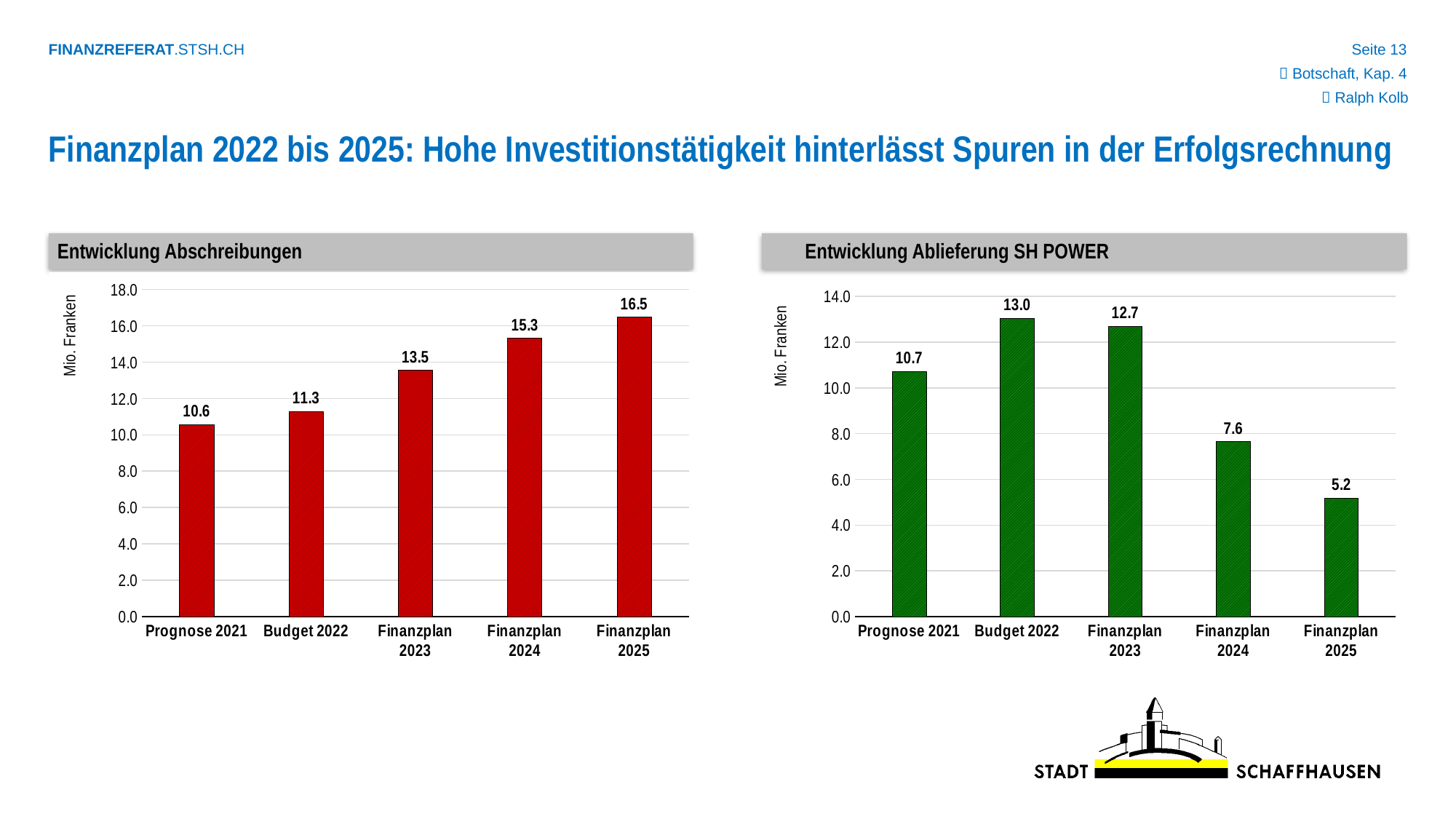
In the 'Entwicklung Ablieferung SH POWER' chart, which category has the lowest value? Finanzplan 2025 In the 'Entwicklung Abschreibungen' chart, what is the difference between Finanzplan 2025 and Prognose 2021? 5.9 In the 'Entwicklung Abschreibungen' chart, do the values rise or fall from Prognose 2021 to Finanzplan 2025? rise What kind of chart is 'Entwicklung Ablieferung SH POWER'? bar chart What unit is shown on the y axis of the 'Entwicklung Ablieferung SH POWER' chart? Mio. Franken How many categories are shown in the 'Entwicklung Abschreibungen' chart? 5 In the 'Entwicklung Ablieferung SH POWER' chart, what is the difference between Finanzplan 2023 and Finanzplan 2024? 5.1 In the 'Entwicklung Ablieferung SH POWER' chart, what is the value for Budget 2022? 13.0 In the 'Entwicklung Ablieferung SH POWER' chart, which is larger: Prognose 2021 or Finanzplan 2024? Prognose 2021 In the 'Entwicklung Abschreibungen' chart, which category has the highest value? Finanzplan 2025 In the 'Entwicklung Abschreibungen' chart, is the value for Finanzplan 2023 greater or less than 12.0? greater In the 'Entwicklung Abschreibungen' chart, what is the value for Finanzplan 2024? 15.3